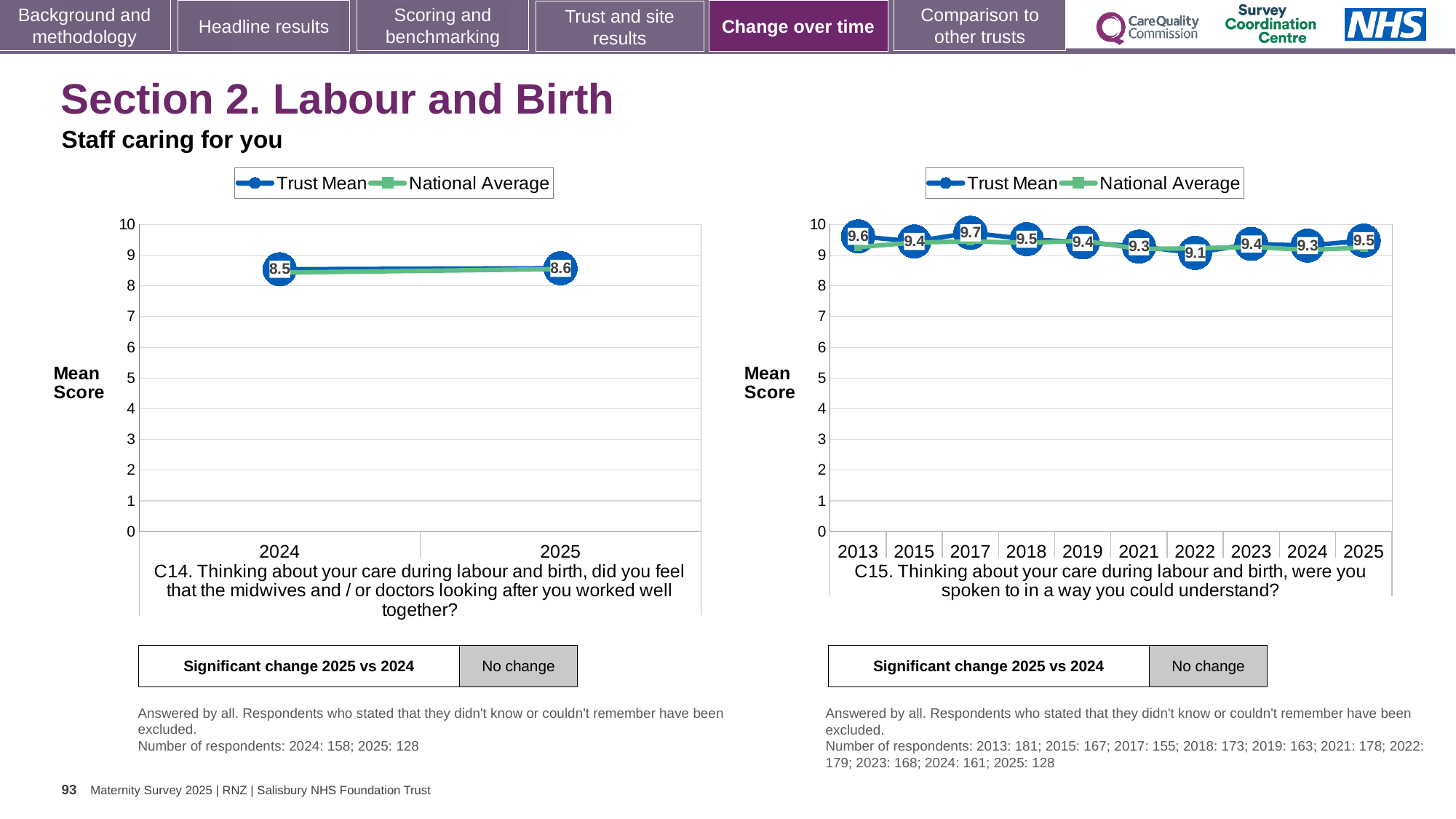
In the C15 chart on the right, how many years are plotted on the x axis? 10 In the C15 chart on the right, is the Trust Mean score for 2013 or 2025 higher? 2013 In the C14 chart on the left, what is the Trust Mean score for 2025? 8.6 In the C14 chart on the left, what is the Trust Mean score for 2024? 8.5 In the C15 chart on the right, which year has the highest Trust Mean score? 2017 In the C14 chart on the left, how many years are plotted on the x axis? 2 In the C15 chart on the right, which year has the lowest Trust Mean score? 2022 How many series does the legend of the C15 chart on the right list? 2 In the C15 chart on the right, what is the Trust Mean score for 2022? 9.1 What type of chart is the C14 chart on the left? Line chart In the C14 chart on the left, what is the difference between the Trust Mean scores for 2025 and 2024? 0.1 In the C15 chart on the right, what is the Trust Mean score for 2017? 9.7